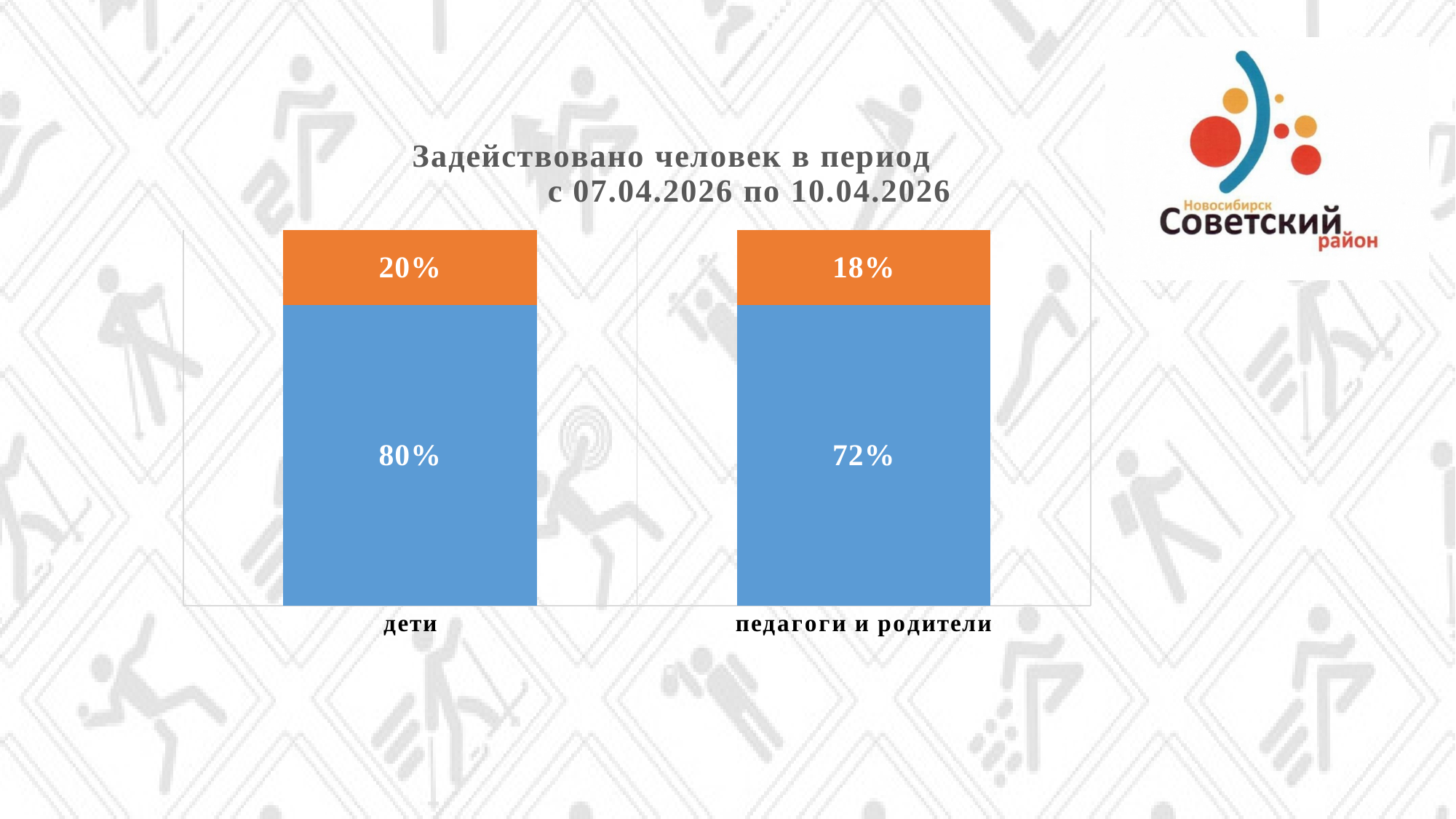
What is the total of the stacked bar for дети? 100% How many categories are shown on the x axis? 2 What is the difference between the blue segment for дети and the blue segment for педагоги и родители? 8% What is the difference between the orange segments for дети and педагоги и родители? 2% What kind of chart is shown on the slide? bar chart What is the title of the chart? Задействовано человек в период с 07.04.2026 по 10.04.2026 Which category has the larger blue segment, дети or педагоги и родители? дети What is the value of the orange segment for дети? 20% What is the value of the blue segment for педагоги и родители? 72% What is the value of the blue segment for дети? 80% Which category has the smaller orange segment? педагоги и родители What is the value of the orange segment for педагоги и родители? 18%